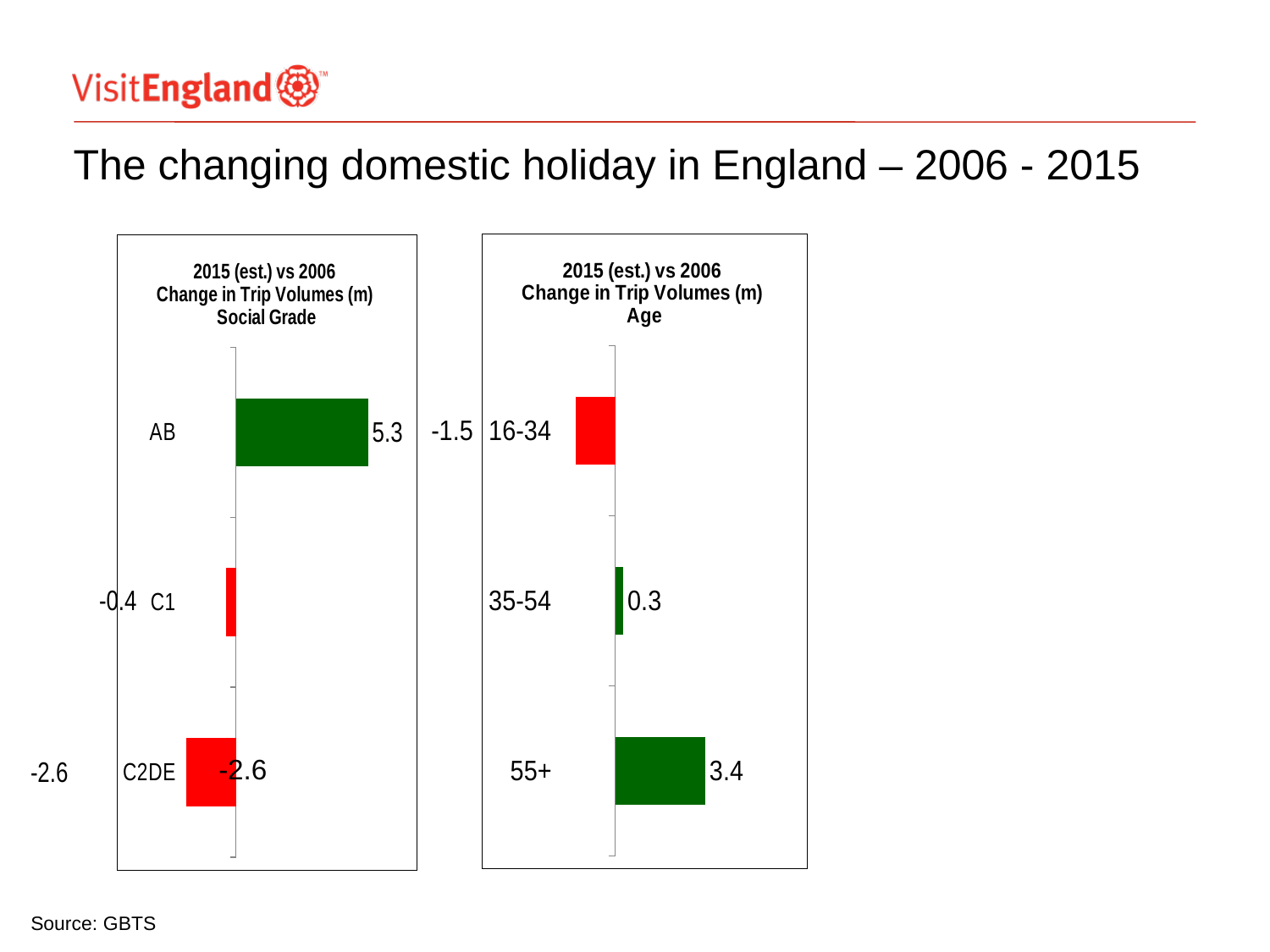
How many categories are shown in the Age chart? 3 In the Age chart, what is the change in trip volumes for 16-34? -1.5 In the Social Grade chart, what is the change in trip volumes for AB? 5.3 In the Social Grade chart, what is the change in trip volumes for C1? -0.4 In the Age chart, what is the change in trip volumes for 55+? 3.4 In the Age chart, which age group has the highest change in trip volumes? 55+ In the Social Grade chart, which social grade has the lowest change in trip volumes? C2DE In the Social Grade chart, which is larger, the change for AB or the change for C1? AB In the Age chart, what colour is the bar for 16-34? Red What kind of chart is the Social Grade chart? Bar chart In the Social Grade chart, what is the change in trip volumes for C2DE? -2.6 In the Age chart, what is the difference between the change for 55+ and the change for 35-54? 3.1